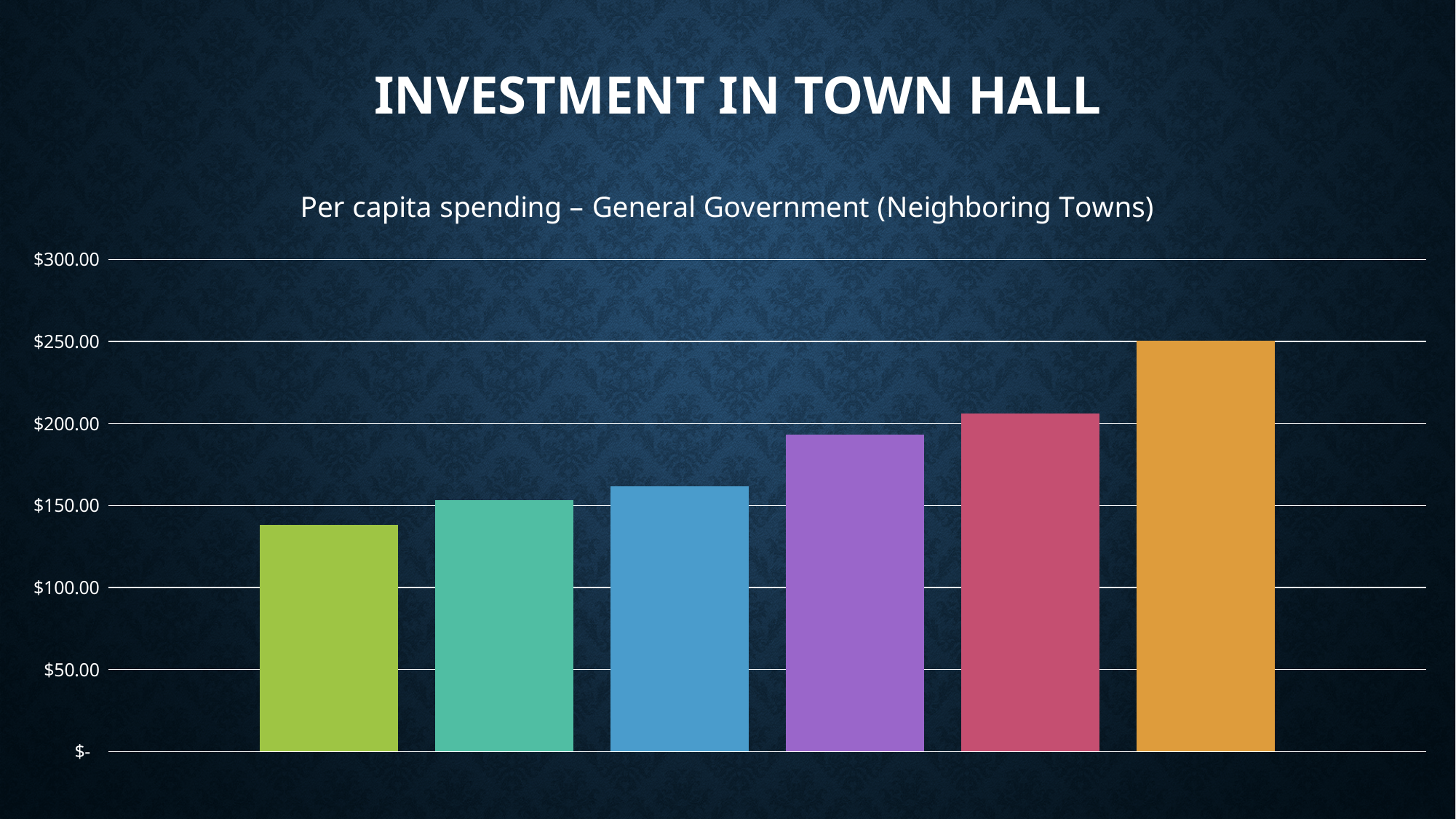
What is the title of the chart? Per capita spending – General Government (Neighboring Towns) Do the bar values rise or fall from left to right across the chart? rise Is the value of the purple (fourth) bar greater or less than $200.00? less How many bars are plotted in the chart? 6 What is the highest value shown on the vertical axis? $300.00 Which is larger, the value of the purple bar or the value of the blue bar? the purple bar What kind of chart is shown on the slide? bar chart Which bar is the shortest in the chart? the green bar (leftmost) Is the value of the leftmost (green) bar greater or less than $150.00? less Is the value of the red (fifth) bar greater or less than $200.00? greater Which bar is the tallest in the chart? the orange bar (rightmost)